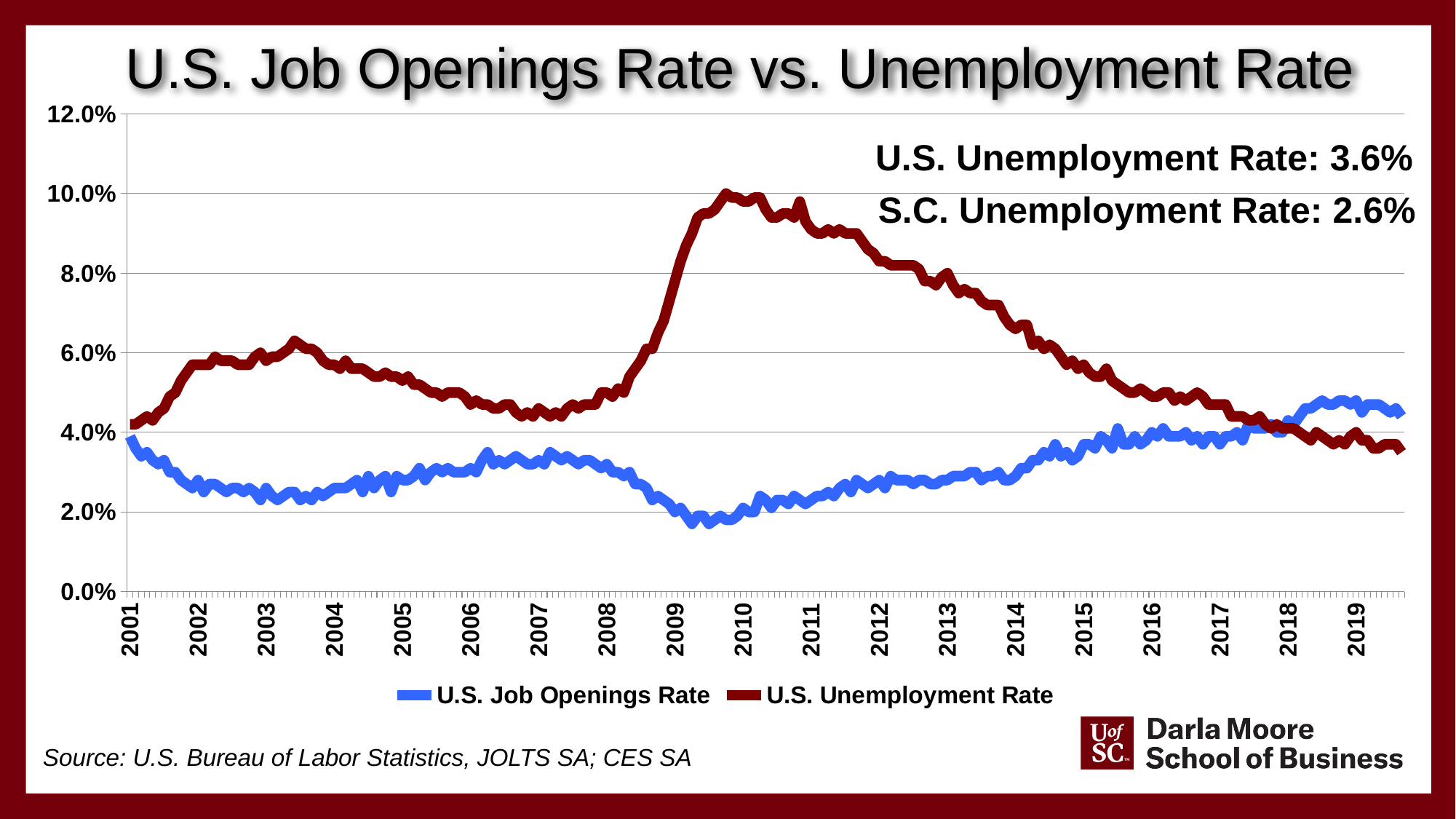
Which colour is used for the U.S. Unemployment Rate line? dark red What is the title of the chart? U.S. Job Openings Rate vs. Unemployment Rate What kind of chart is shown on the slide? line chart How many series does the legend list? 2 Is the U.S. Job Openings Rate in late 2018 greater or less than 4.0%? greater How many years are labelled on the x axis? 19 Is the U.S. Unemployment Rate in 2010 greater or less than 8.0%? greater Which series has the higher value in 2010, U.S. Job Openings Rate or U.S. Unemployment Rate? U.S. Unemployment Rate Does the U.S. Job Openings Rate rise or fall from 2009 to 2018? rise Is the U.S. Unemployment Rate in 2007 greater or less than 6.0%? less Does the U.S. Unemployment Rate rise or fall from 2010 to 2017? fall